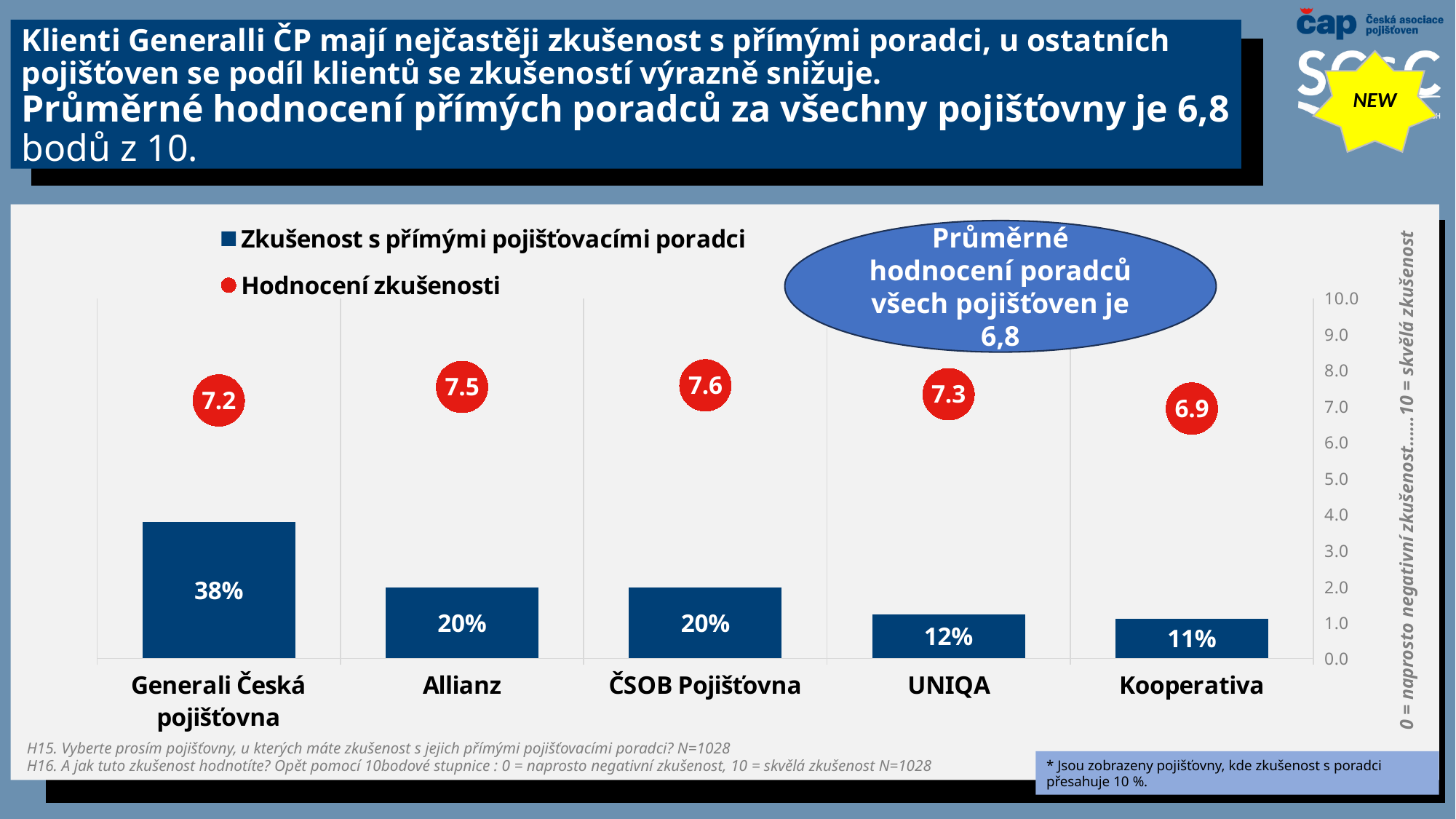
What percentage of clients have experience with direct insurance advisors at Generali Česká pojišťovna? 38% How many insurers are shown on the chart? 5 What type of chart is used to show the share of clients with experience with direct advisors? Bar chart Which has a higher rating of experience, Allianz or UNIQA? Allianz Which insurer has the highest rating of experience? ČSOB Pojišťovna Which insurer has the highest share of clients with experience with direct insurance advisors? Generali Česká pojišťovna What is the difference in the share of clients with advisor experience between Generali Česká pojišťovna and UNIQA? 26 percentage points What is the average rating of advisors across all insurers, as stated in the blue oval on the chart? 6,8 What is the rating of experience (Hodnocení zkušenosti) for ČSOB Pojišťovna? 7.6 How many series does the legend list? 2 What is the rating of experience for Kooperativa? 6.9 Which insurer has the lowest rating of experience? Kooperativa